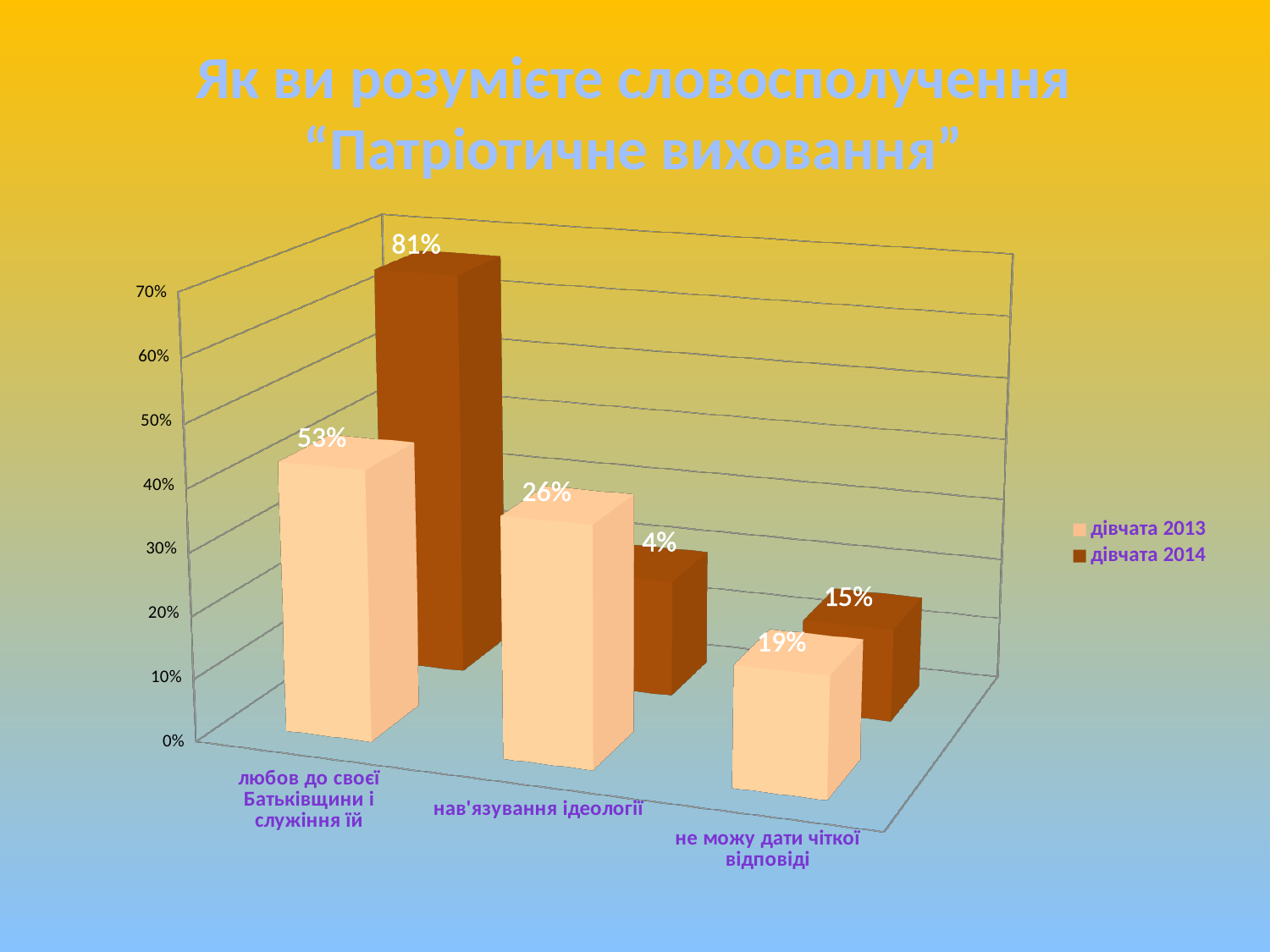
What is the value for "дівчата 2014" in the category "не можу дати чіткої відповіді"? 15% What is the title of the chart on the slide? Як ви розумієте словосполучення "Патріотичне виховання" Which is larger for "нав'язування ідеології": the value for "дівчата 2013" or for "дівчата 2014"? дівчата 2013 What is the value for "дівчата 2013" in the category "не можу дати чіткої відповіді"? 19% How many series does the legend list? 2 What is the value for "дівчата 2013" in the category "нав'язування ідеології"? 26% Which category has the highest value for "дівчата 2014"? любов до своєї Батьківщини і служіння їй What is the value for "дівчата 2014" in the category "любов до своєї Батьківщини і служіння їй"? 81% What is the difference between the "дівчата 2014" and "дівчата 2013" values for "любов до своєї Батьківщини і служіння їй"? 28% How many categories are shown on the x axis? 3 What kind of chart is shown on the slide? bar chart